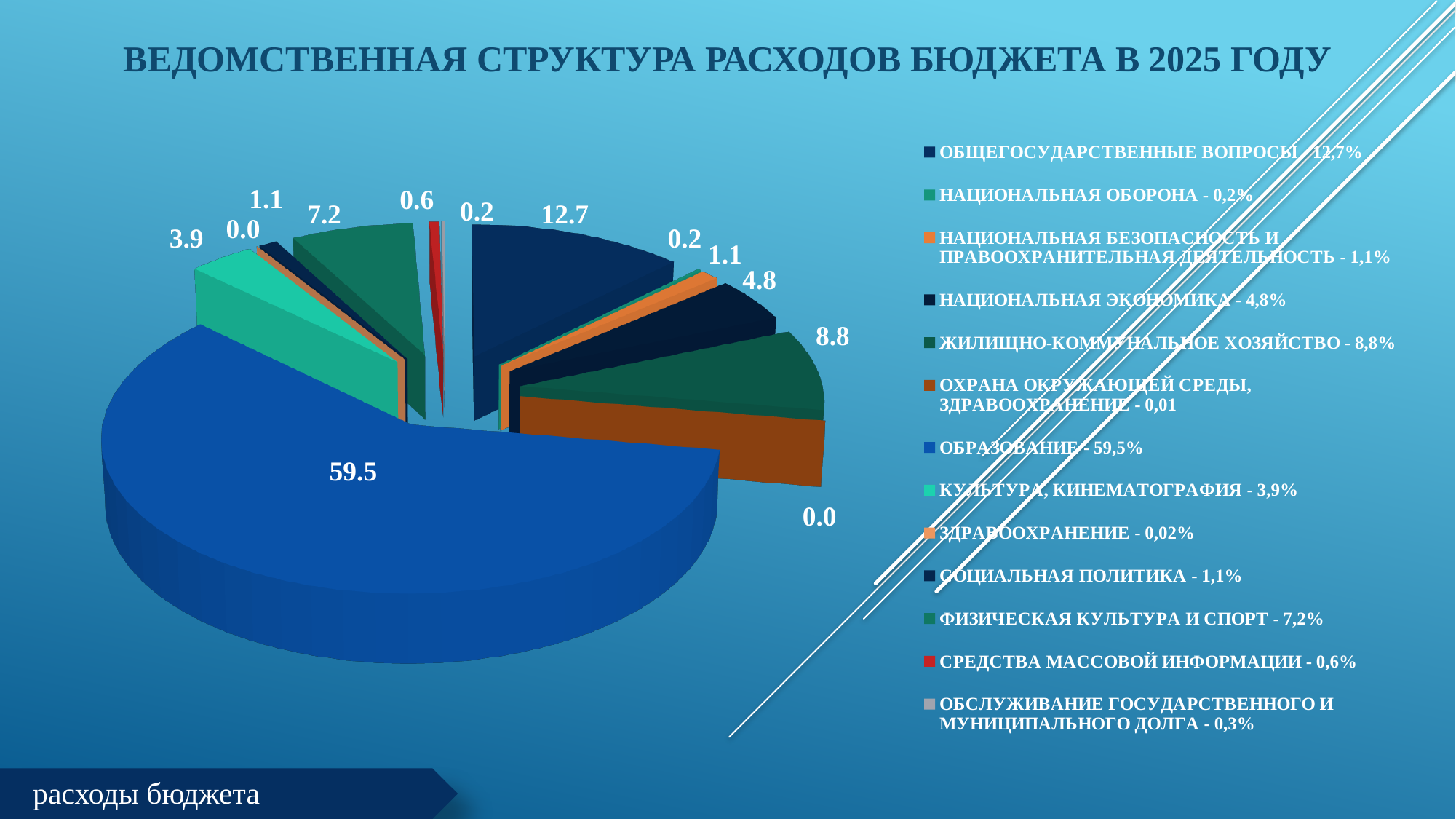
What is the data label for the ФИЗИЧЕСКАЯ КУЛЬТУРА И СПОРТ slice? 7.2 What percentage does the legend give for СРЕДСТВА МАССОВОЙ ИНФОРМАЦИИ? 0,6% What is the data label for the ОБРАЗОВАНИЕ slice? 59.5 Which is larger, the ЖИЛИЩНО-КОММУНАЛЬНОЕ ХОЗЯЙСТВО slice or the КУЛЬТУРА, КИНЕМАТОГРАФИЯ slice? ЖИЛИЩНО-КОММУНАЛЬНОЕ ХОЗЯЙСТВО What kind of chart is shown on the slide? Pie chart Which category has the largest share of the pie? ОБРАЗОВАНИЕ How many categories does the legend list? 13 What is the title of the slide? ВЕДОМСТВЕННАЯ СТРУКТУРА РАСХОДОВ БЮДЖЕТА В 2025 ГОДУ What is the data label for the ЖИЛИЩНО-КОММУНАЛЬНОЕ ХОЗЯЙСТВО slice? 8.8 What is the difference between the ОБЩЕГОСУДАРСТВЕННЫЕ ВОПРОСЫ value (12.7) and the НАЦИОНАЛЬНАЯ ЭКОНОМИКА value (4.8)? 7.9 What percentage does the legend give for ОБСЛУЖИВАНИЕ ГОСУДАРСТВЕННОГО И МУНИЦИПАЛЬНОГО ДОЛГА? 0,3% What is the data label for the ОБЩЕГОСУДАРСТВЕННЫЕ ВОПРОСЫ slice? 12.7